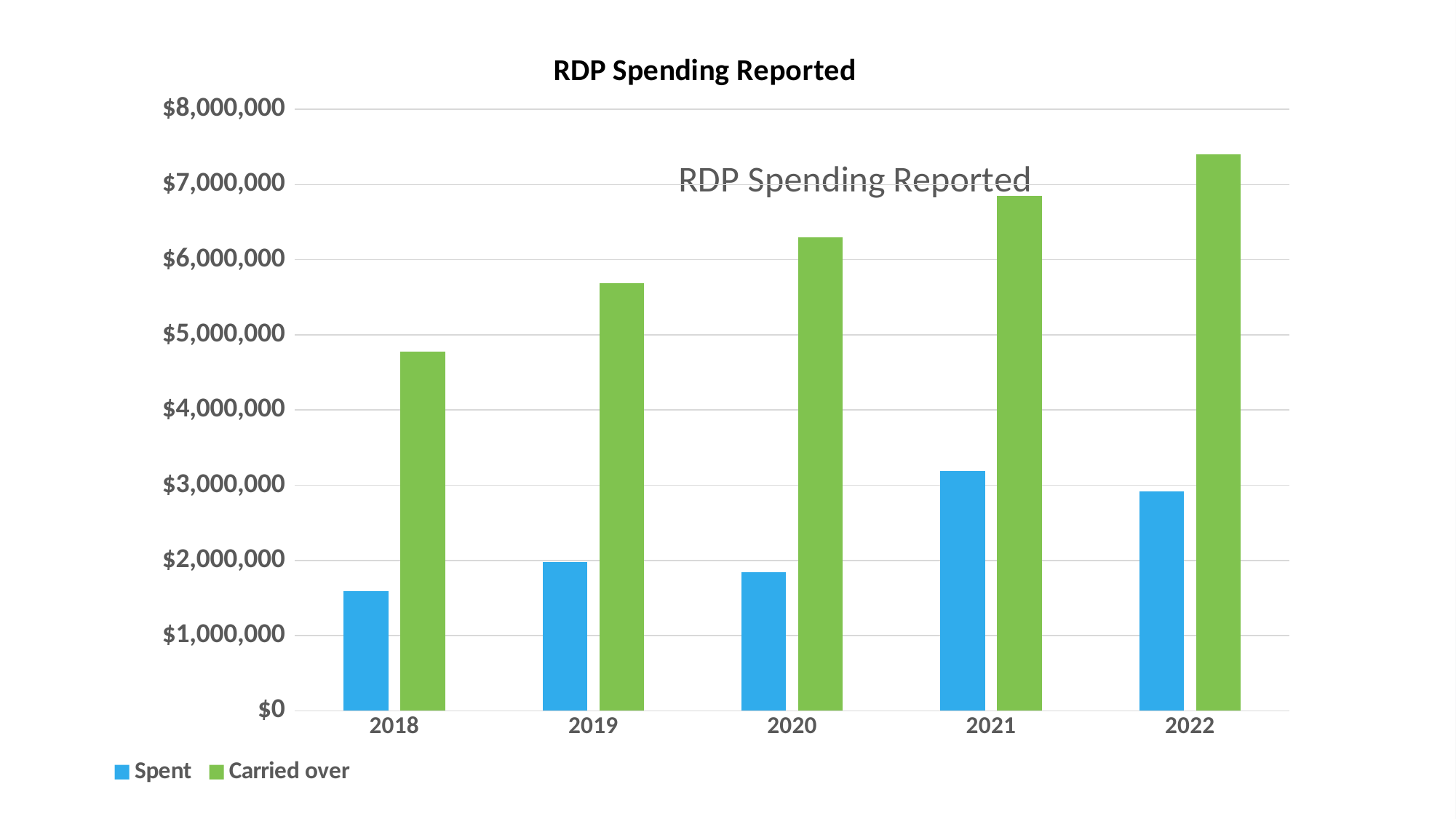
Is the Carried over value for 2022 greater or less than $7,000,000? greater Which year has the highest Spent value? 2021 Which year has the lowest Carried over value? 2018 Is the Spent value for 2018 greater or less than $2,000,000? less Which year has the highest Carried over value? 2022 What is the title of the chart? RDP Spending Reported Which is larger in 2020, Spent or Carried over? Carried over How many series does the legend list? 2 Which year has the lowest Spent value? 2018 Do the Carried over values rise or fall from 2018 to 2022? rise How many years are shown on the x axis? 5 What kind of chart is shown on the slide? bar chart